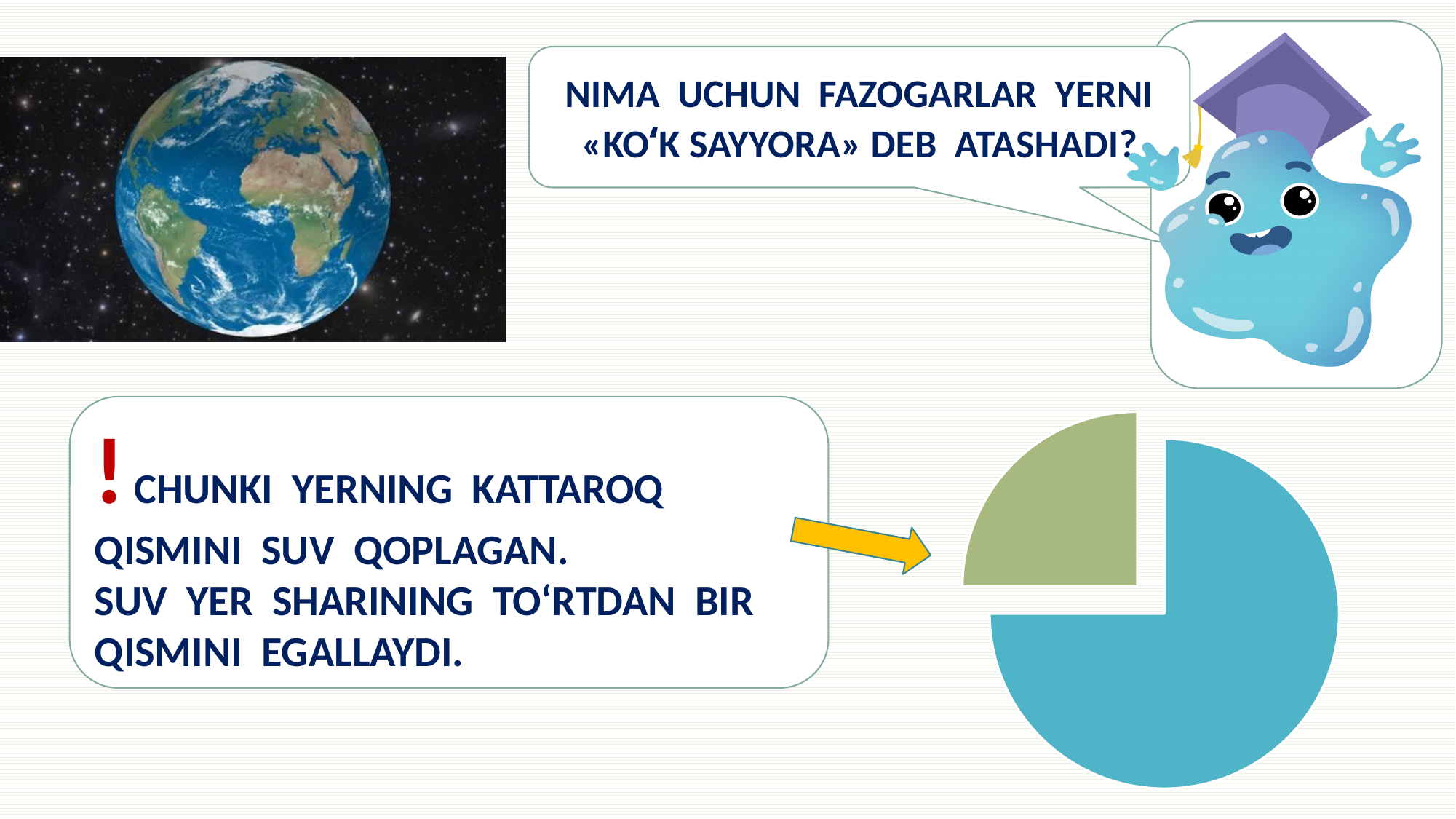
Which colour slice is the smallest in the pie chart? green How many slices does the pie chart on the slide have? 2 Does the pie chart on the slide show a legend? No In the pie chart, which slice is larger, the blue one or the green one? the blue one Which colour slice takes up the largest share of the pie chart? blue Which slice of the pie chart is pulled out (exploded) from the rest of the pie? the green slice What kind of chart is shown on the right side of the slide? pie chart